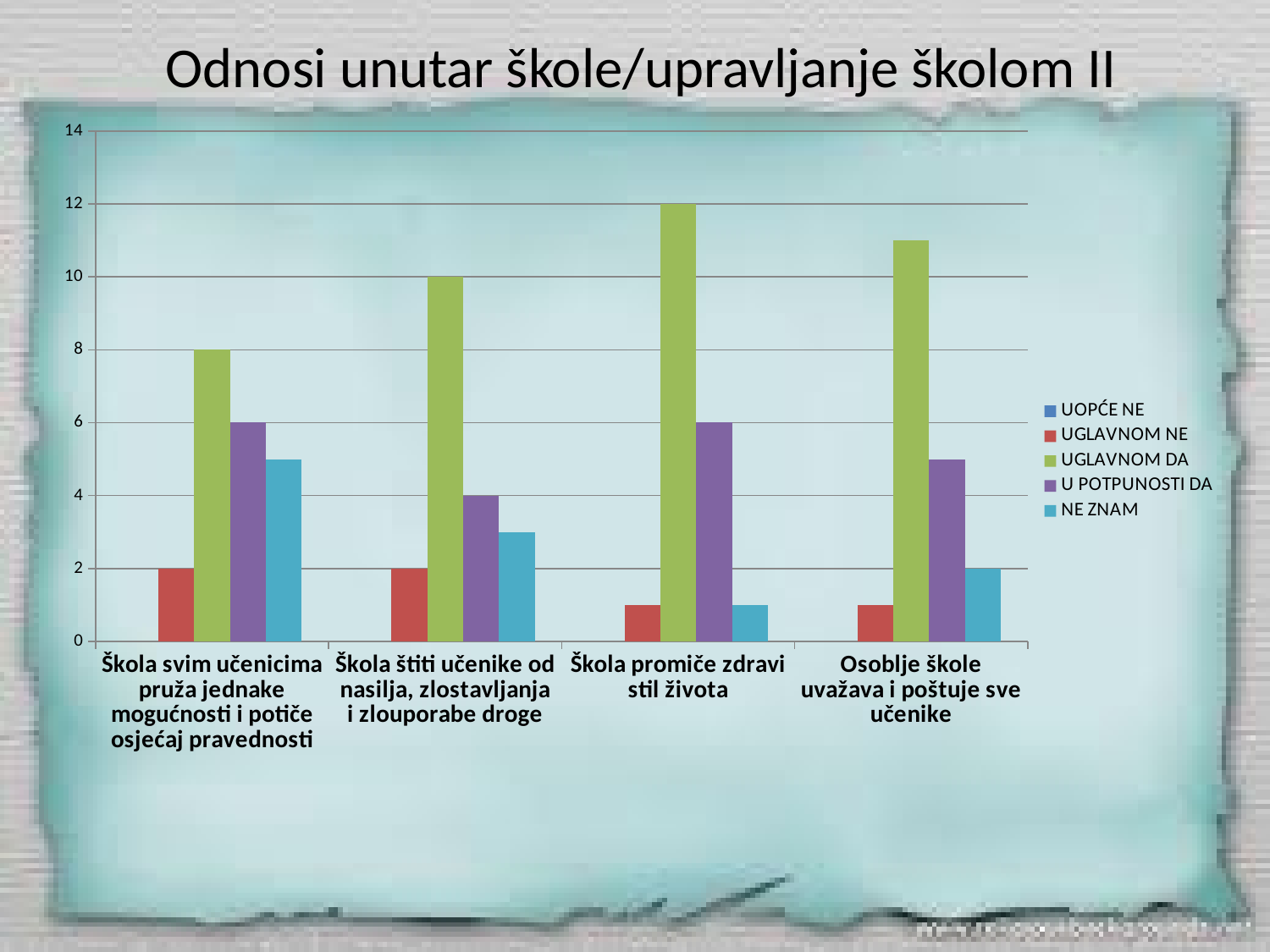
What is the difference between the UGLAVNOM DA values for 'Škola promiče zdravi stil života' and 'Škola svim učenicima pruža jednake mogućnosti i potiče osjećaj pravednosti'? 4 How many series does the legend list? 5 What type of chart is shown on the slide? bar chart How many categories are shown on the x axis? 4 What is the value of UGLAVNOM DA for 'Škola štiti učenike od nasilja, zlostavljanja i zlouporabe droge'? 10 Is the value of UGLAVNOM DA for 'Osoblje škole uvažava i poštuje sve učenike' greater or less than 10? greater Is the value of NE ZNAM for 'Škola svim učenicima pruža jednake mogućnosti i potiče osjećaj pravednosti' greater or less than 4? greater Which category has the lowest UGLAVNOM DA value? Škola svim učenicima pruža jednake mogućnosti i potiče osjećaj pravednosti Which category has the highest UGLAVNOM DA value? Škola promiče zdravi stil života What is the value of UGLAVNOM DA for 'Škola svim učenicima pruža jednake mogućnosti i potiče osjećaj pravednosti'? 8 What is the value of UGLAVNOM DA for 'Škola promiče zdravi stil života'? 12 What is the value of U POTPUNOSTI DA for 'Škola promiče zdravi stil života'? 6